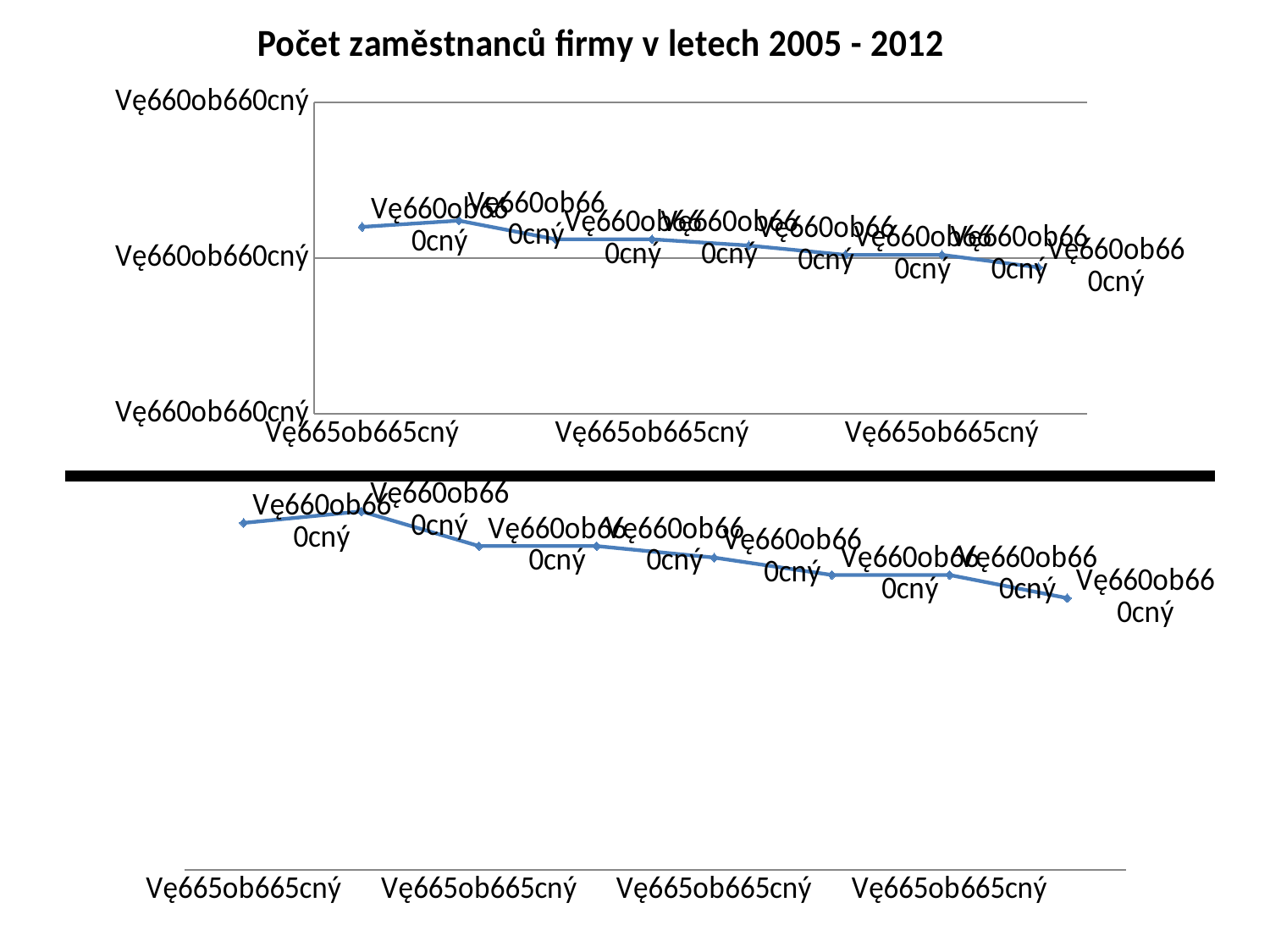
What kind of chart is the bottom chart on the slide? line chart In the top chart, do the values generally rise or fall from left to right along the x axis? fall What kind of chart is the top chart on the slide? line chart What colour is the line in the top chart? blue In the top chart, is the first point on the line higher or lower than the last point? higher In the bottom chart, is the first point on the line higher or lower than the last point? higher How many data points are plotted on the line in the top chart? 8 What is the title of the chart at the top of the slide? Počet zaměstnanců firmy v letech 2005 - 2012 How many data points are plotted on the line in the bottom chart? 8 In the top chart, is the second point on the line higher or lower than the first point? higher In the bottom chart, do the values generally rise or fall from left to right along the x axis? fall